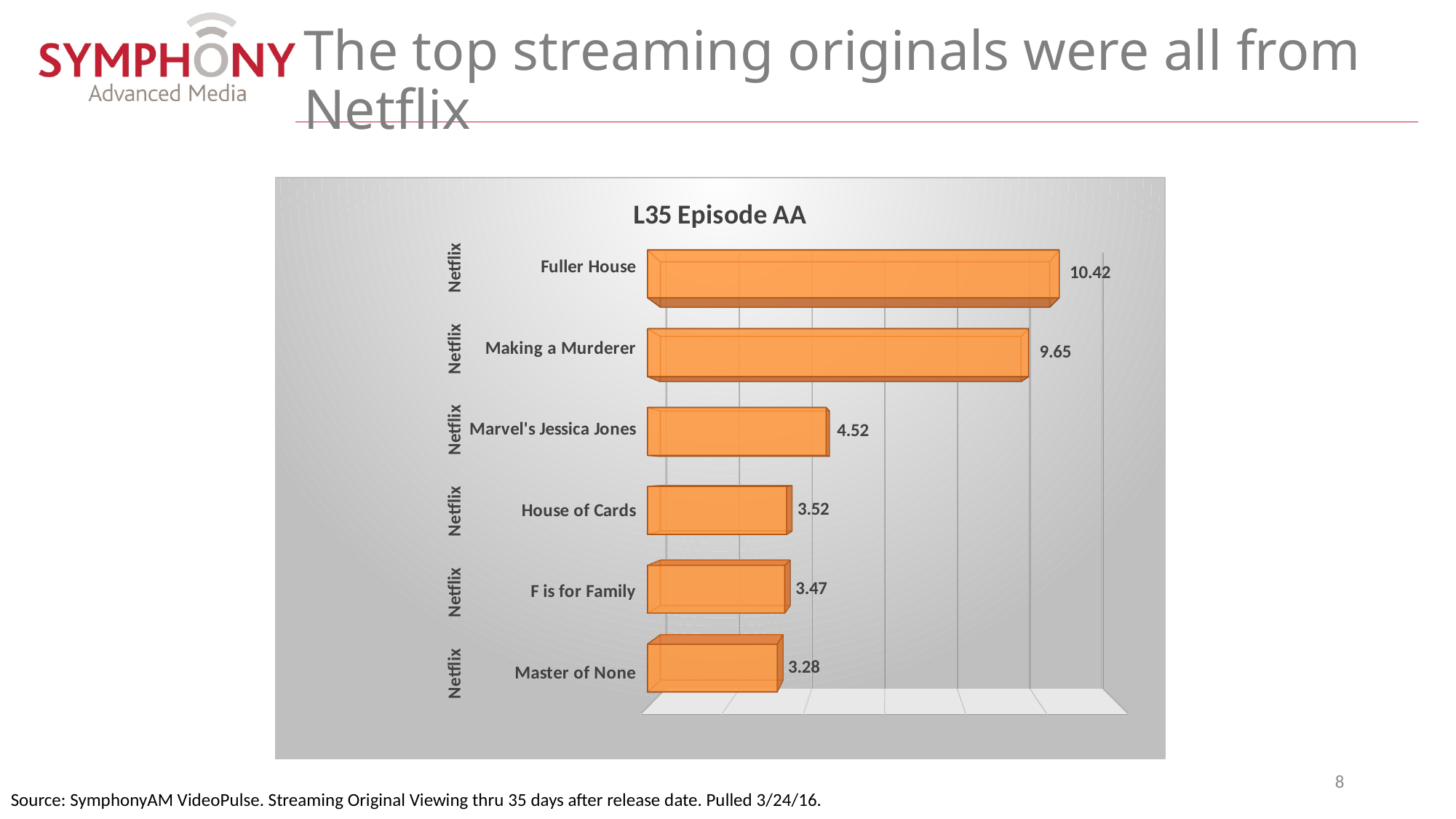
How many titles are shown in the chart? 6 What is the difference between the values for Fuller House and Making a Murderer? 0.77 What is the difference between the values for House of Cards and F is for Family? 0.05 What kind of chart is shown on the slide? Bar chart Which title has the lowest L35 Episode AA value? Master of None What is the L35 Episode AA value for Fuller House? 10.42 What is the L35 Episode AA value for Marvel's Jessica Jones? 4.52 What is the title of the chart? L35 Episode AA What is the L35 Episode AA value for Master of None? 3.28 Which title has the highest L35 Episode AA value? Fuller House What is the L35 Episode AA value for Making a Murderer? 9.65 Which has a larger value, Marvel's Jessica Jones or House of Cards? Marvel's Jessica Jones